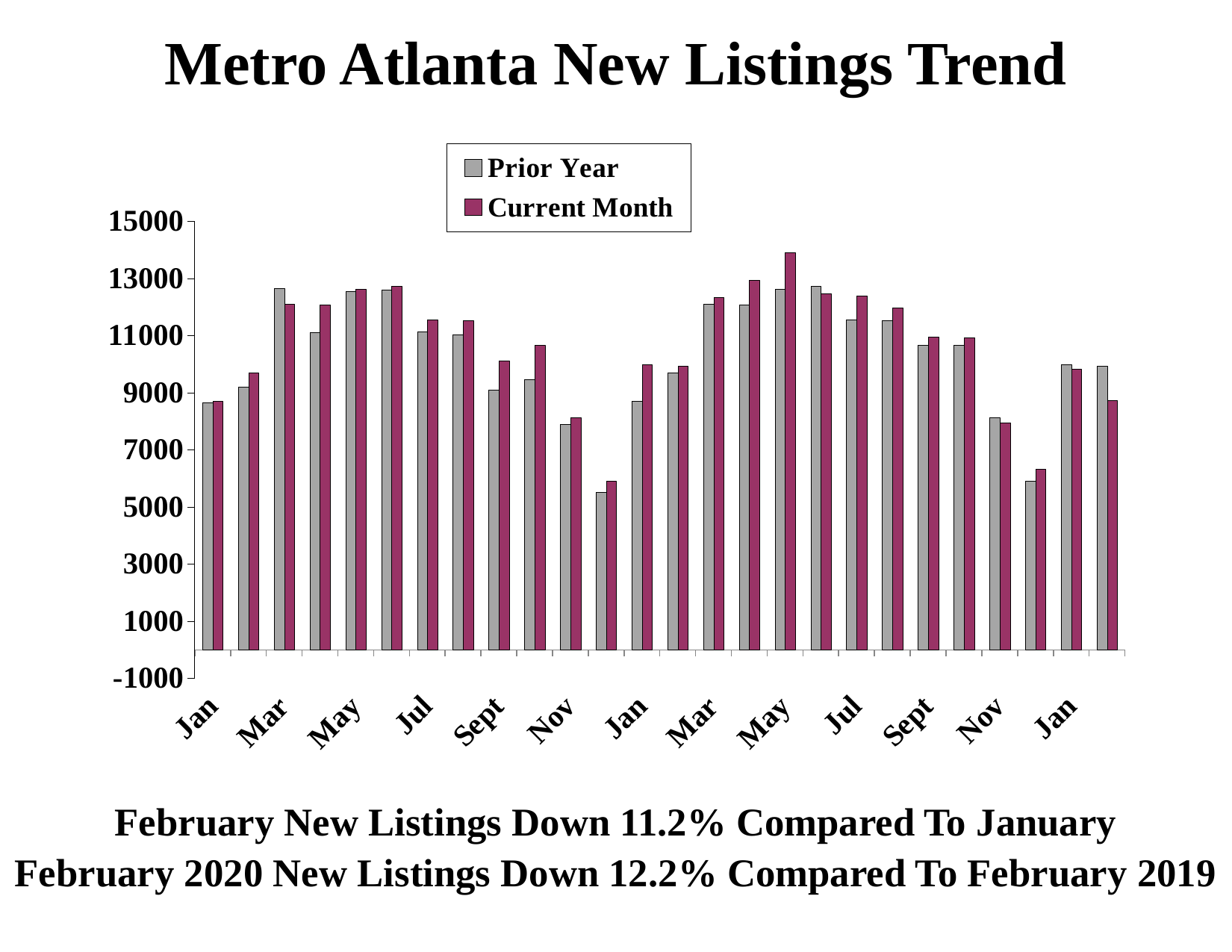
What kind of chart is shown on the slide? bar chart For the last Jan on the right of the chart, which is larger: the Prior Year bar or the Current Month bar? Prior Year Which month has the tallest Current Month bar? May (the second May) For the second May, which is larger: the Prior Year bar or the Current Month bar? Current Month What is the title of the chart? Metro Atlanta New Listings Trend Is the Current Month value for the first Nov greater or less than 7000? greater Is the Current Month value for the first Mar greater or less than 11000? greater Is the Current Month value for the second May greater or less than 13000? greater Do the Current Month values rise or fall from the first Jan to the first Mar? rise What are the two series named in the legend? Prior Year and Current Month How many series does the legend list? 2